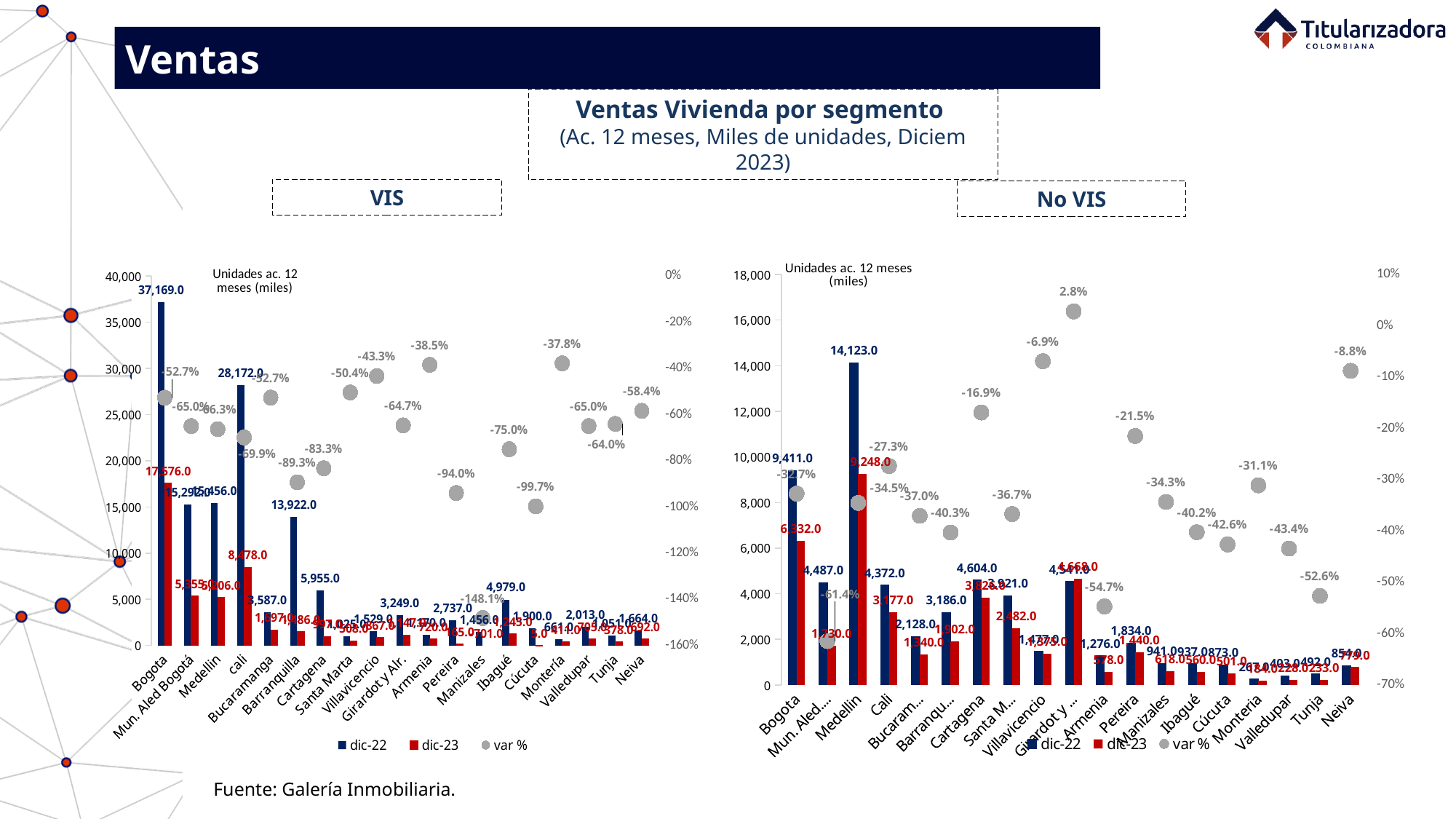
In the VIS chart, which has the larger dic-22 value, cali or Barranquilla? cali In the No VIS chart, which city has the highest dic-22 value? Medellin In the VIS chart, what is the dic-22 value for Bogota? 37,169.0 In the No VIS chart, what is the difference between the dic-22 and dic-23 values for Bogota? 3,079.0 How many series does the legend of the VIS chart list? 3 How many cities are shown on the x axis of the VIS chart? 19 In the No VIS chart, what is the dic-22 value for Cartagena? 4,604.0 In the VIS chart, what is the var % for Pereira? -94.0% In the No VIS chart, what is the dic-22 value for Medellin? 14,123.0 In the VIS chart, what is the var % for Manizales? -148.1% In the No VIS chart, what is the var % for Girardot y Alr.? 2.8% In the VIS chart, which city has the highest dic-22 value? Bogota